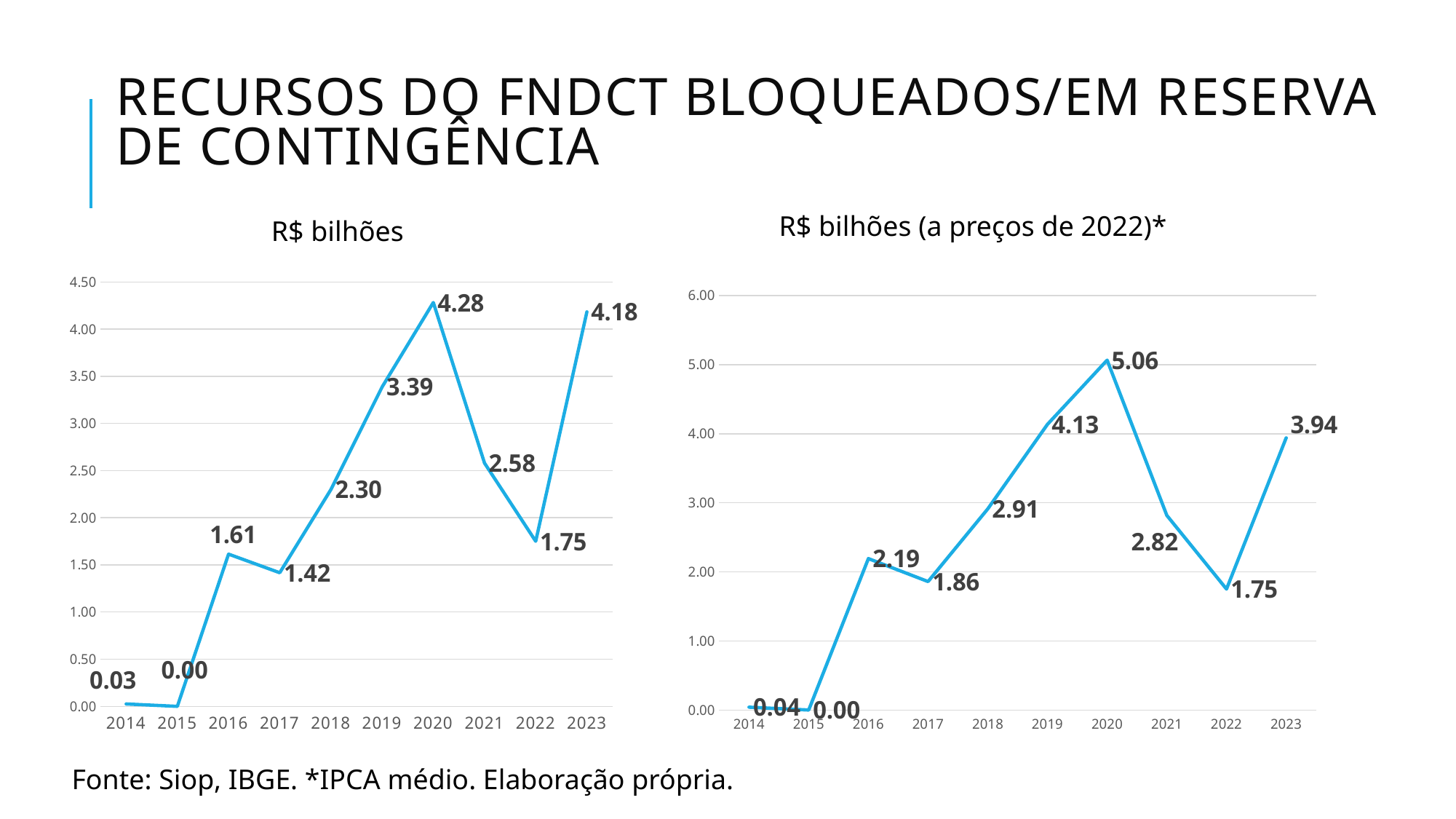
How many years are plotted in the left chart titled 'R$ bilhões'? 10 In the left chart titled 'R$ bilhões', what is the value for 2020? 4.28 In the right chart titled 'R$ bilhões (a preços de 2022)*', which year has the lowest value? 2015 In the left chart titled 'R$ bilhões', is the value for 2019 greater or less than 3.00? greater In the right chart titled 'R$ bilhões (a preços de 2022)*', which is larger, the value for 2018 or the value for 2021? 2018 What kind of chart is the right chart titled 'R$ bilhões (a preços de 2022)*'? line chart In the left chart titled 'R$ bilhões', do the values rise or fall from 2020 to 2022? fall In the right chart titled 'R$ bilhões (a preços de 2022)*', what is the difference between the values for 2020 and 2023? 1.12 In the left chart titled 'R$ bilhões', what is the difference between the values for 2020 and 2022? 2.53 In the right chart titled 'R$ bilhões (a preços de 2022)*', what is the value for 2019? 4.13 In the left chart titled 'R$ bilhões', which year has the highest value? 2020 What is the title of the right chart on the slide? R$ bilhões (a preços de 2022)*